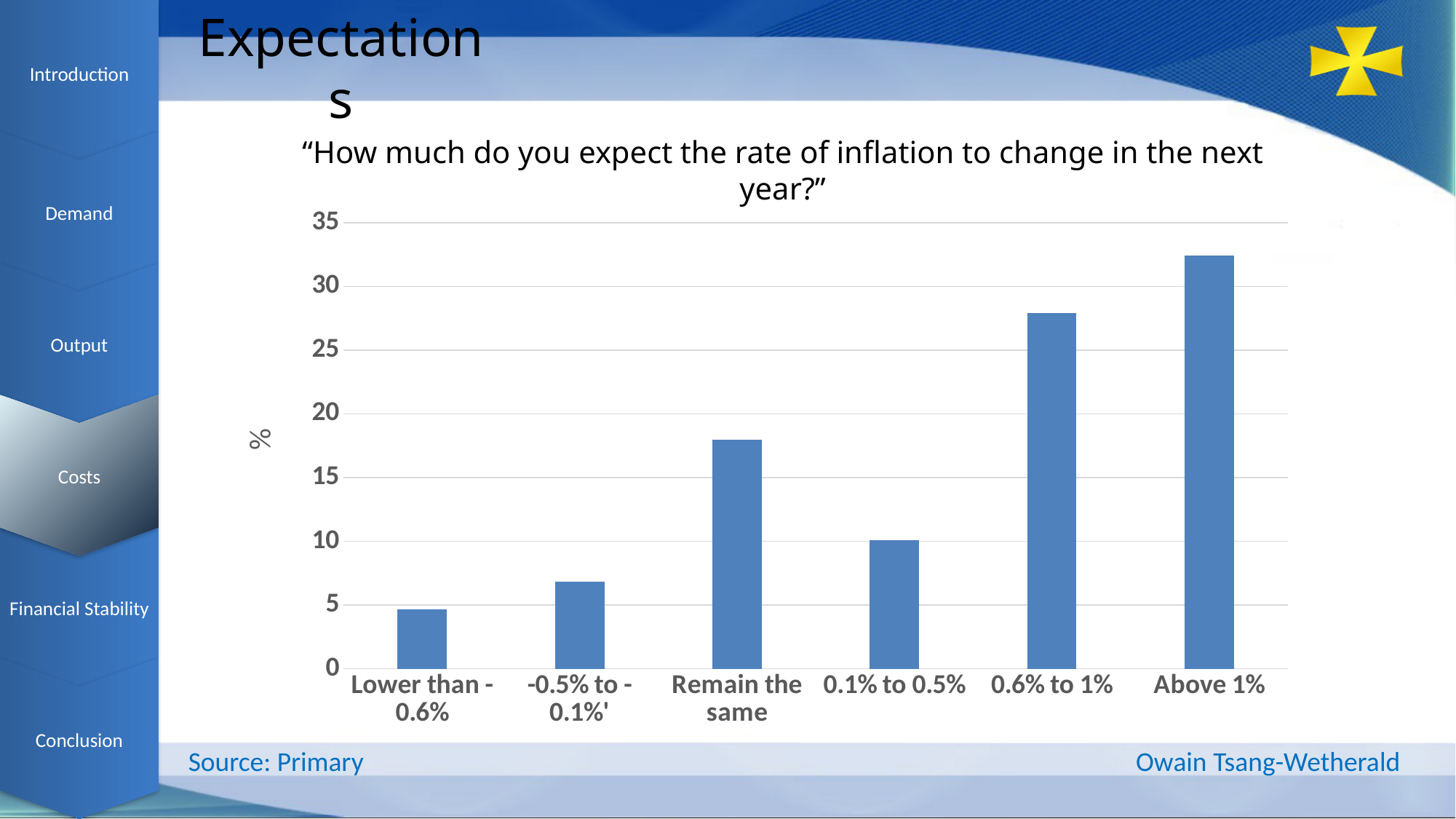
Is the value for "Remain the same" greater or less than 15? greater Which category has the lowest value in the chart? Lower than -0.6% What question is the chart titled with? "How much do you expect the rate of inflation to change in the next year?" What is the label on the y axis of the chart? % What kind of chart is shown on the slide? bar chart Is the value for "0.6% to 1%" greater or less than 25? greater How many categories are shown on the x axis of the chart? 6 Which has a larger value: "0.6% to 1%" or "Above 1%"? Above 1% Which has a larger value: "Remain the same" or "0.1% to 0.5%"? Remain the same Which category has the highest value in the chart? Above 1% Is the value for "Above 1%" greater or less than 30? greater